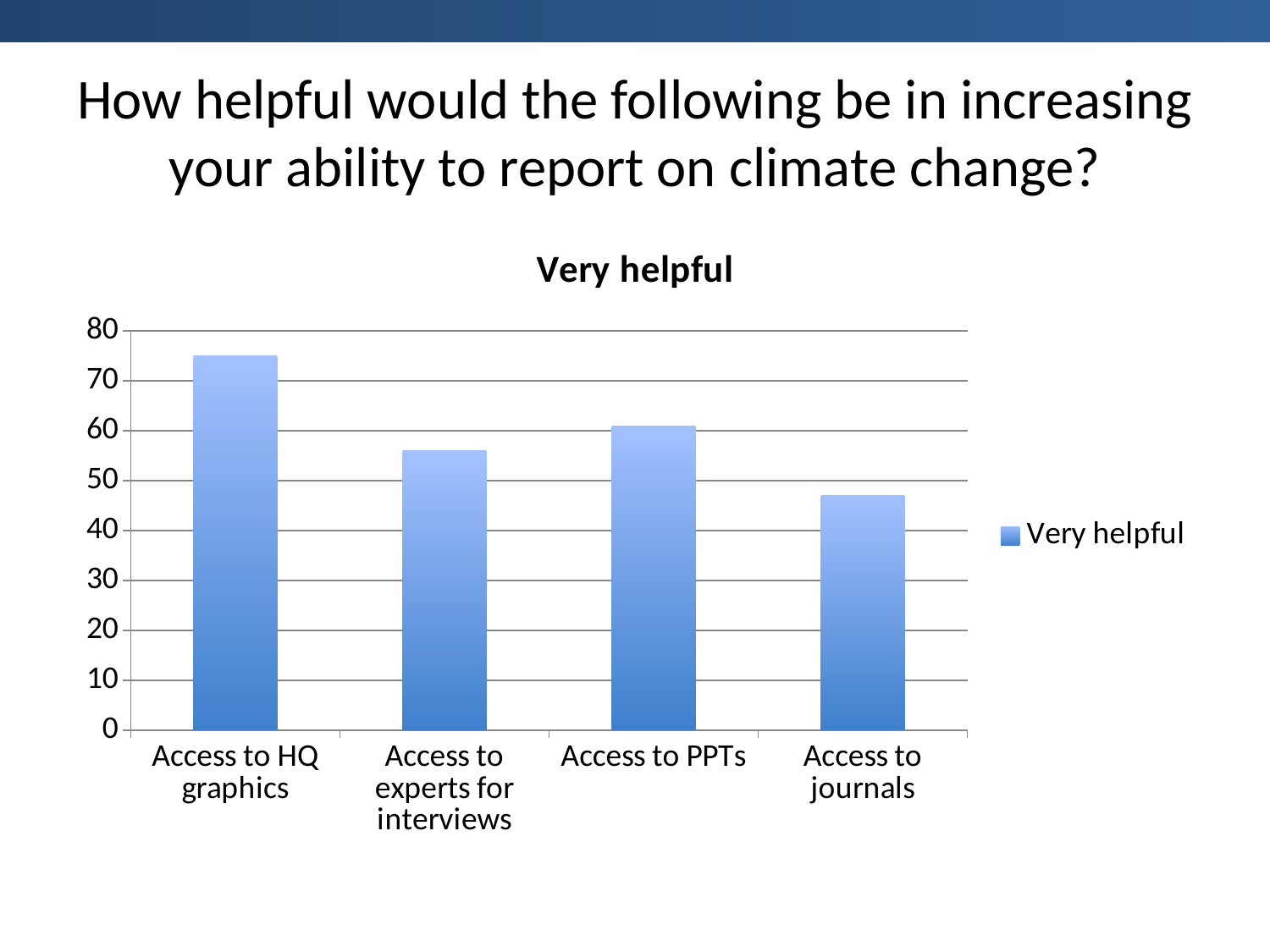
Which is larger, the value for Access to HQ graphics or the value for Access to journals? Access to HQ graphics Which category has the highest value in the chart? Access to HQ graphics How many series does the chart's legend list? 1 Which is larger, the value for Access to PPTs or the value for Access to experts for interviews? Access to PPTs Is the value for Access to journals greater or less than 50? less Is the value for Access to HQ graphics greater or less than 70? greater What is the title of the chart? Very helpful How many categories are shown on the x axis of the chart? 4 Which category has the lowest value in the chart? Access to journals Is the value for Access to experts for interviews greater or less than 60? less What kind of chart is shown on the slide? bar chart